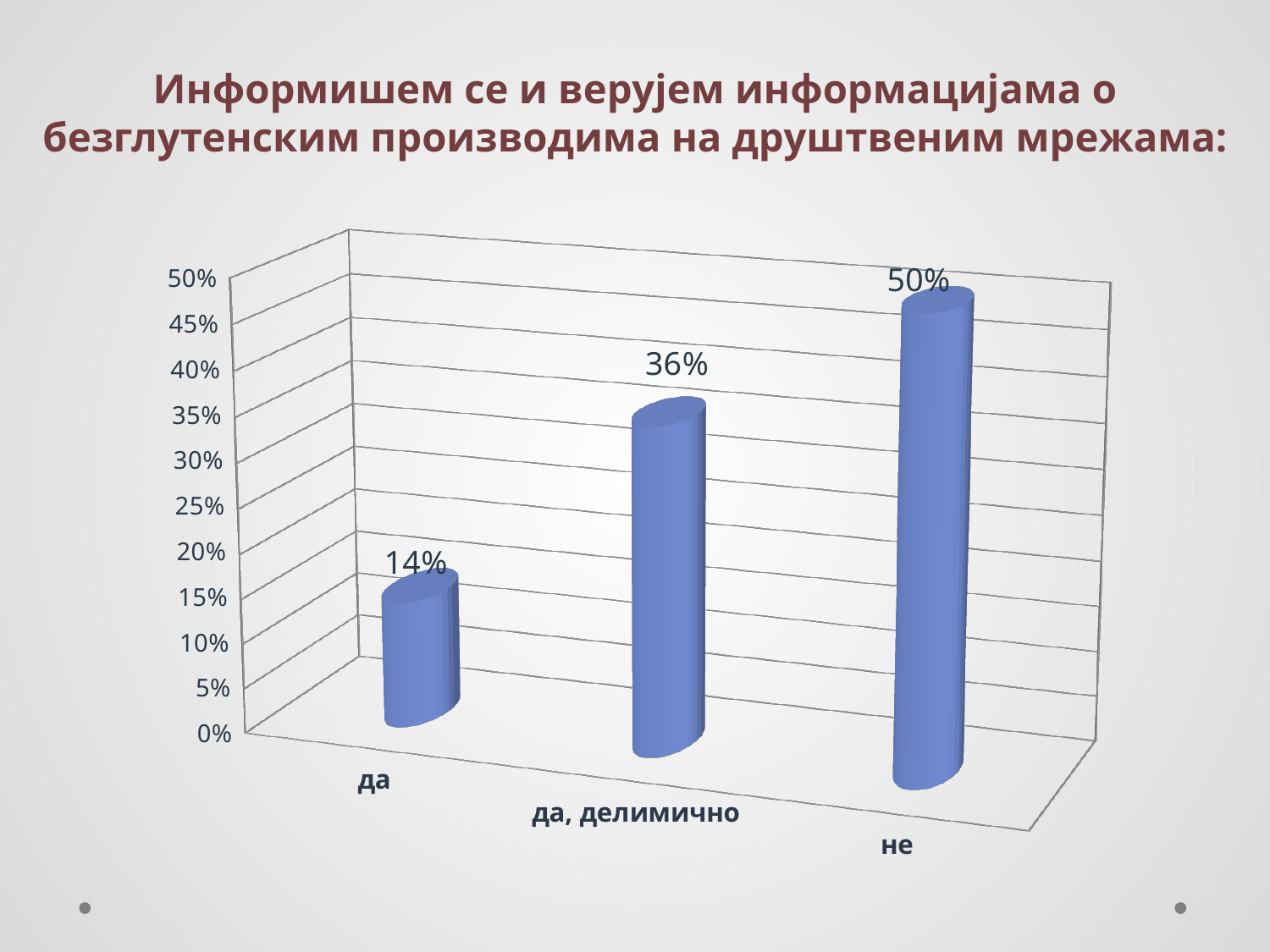
Which is larger, the value for "да, делимично" or the value for "да"? да, делимично What kind of chart is shown on the slide? bar chart How many categories are shown on the chart? 3 Which category has the highest value? не What is the value for "да"? 14% What is the difference between the values for "да, делимично" and "да"? 22% Which category has the lowest value? да What is the value for "да, делимично"? 36% What is the value for "не"? 50% Do the values rise or fall from left to right along the x axis? rise Is the value for "да, делимично" greater or less than 30%? greater What is the difference between the values for "не" and "да"? 36%